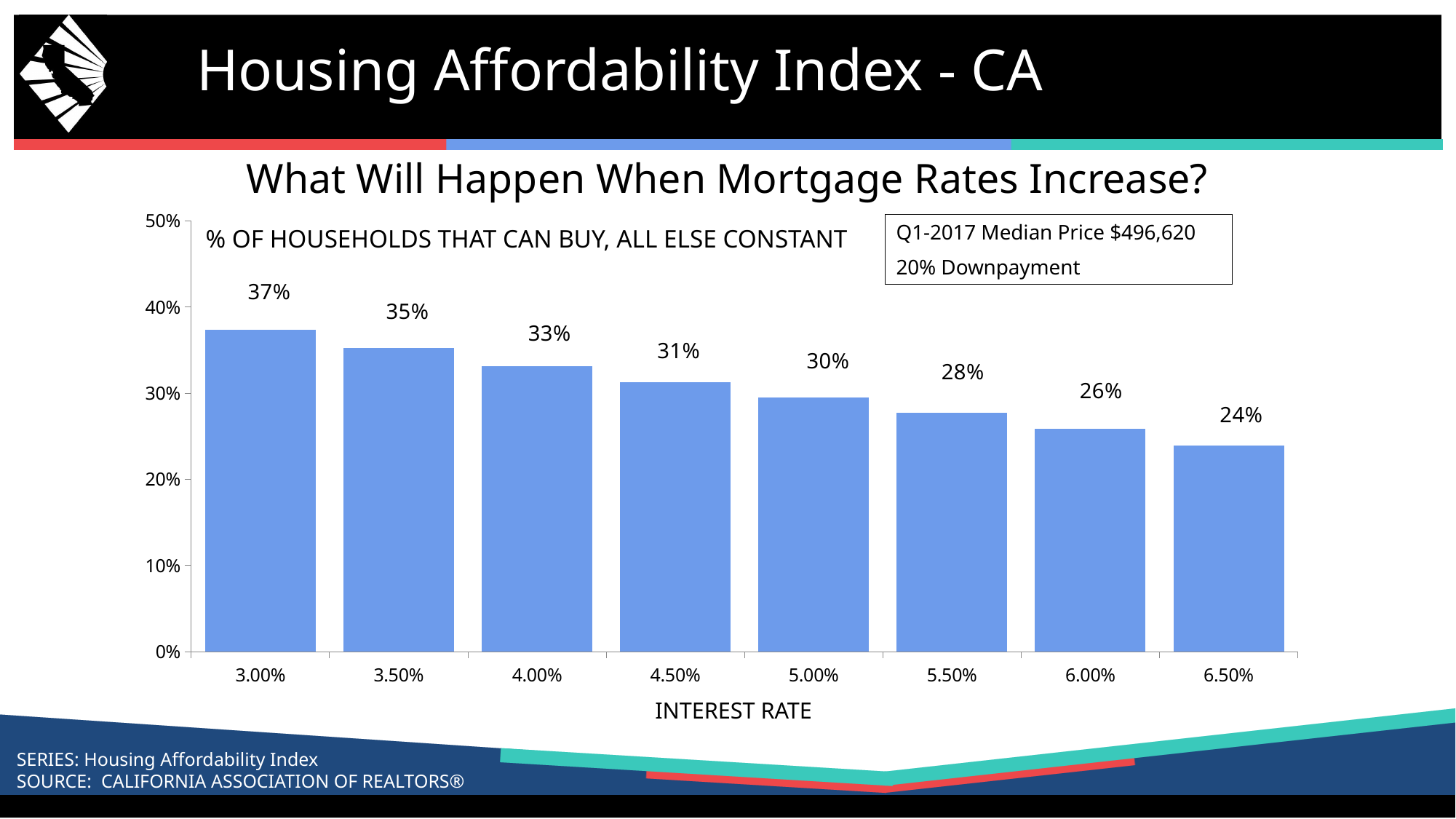
What is the title of the chart? What Will Happen When Mortgage Rates Increase? Which has a higher percentage of households that can buy: 4.50% or 5.50%? 4.50% Which interest rate has the lowest percentage of households that can buy? 6.50% What percentage of households can buy at a 5.00% interest rate? 30% How many interest rate categories are shown on the chart? 8 What is the difference between the percentage of households that can buy at 3.00% and at 6.50%? 13% Which interest rate has the highest percentage of households that can buy? 3.00% What percentage of households can buy at a 6.50% interest rate? 24% What kind of chart is shown on the slide? bar chart Do the values rise or fall as the interest rate increases along the x axis? fall What percentage of households can buy at a 3.00% interest rate? 37% Is the value for 6.00% greater or less than 30%? less